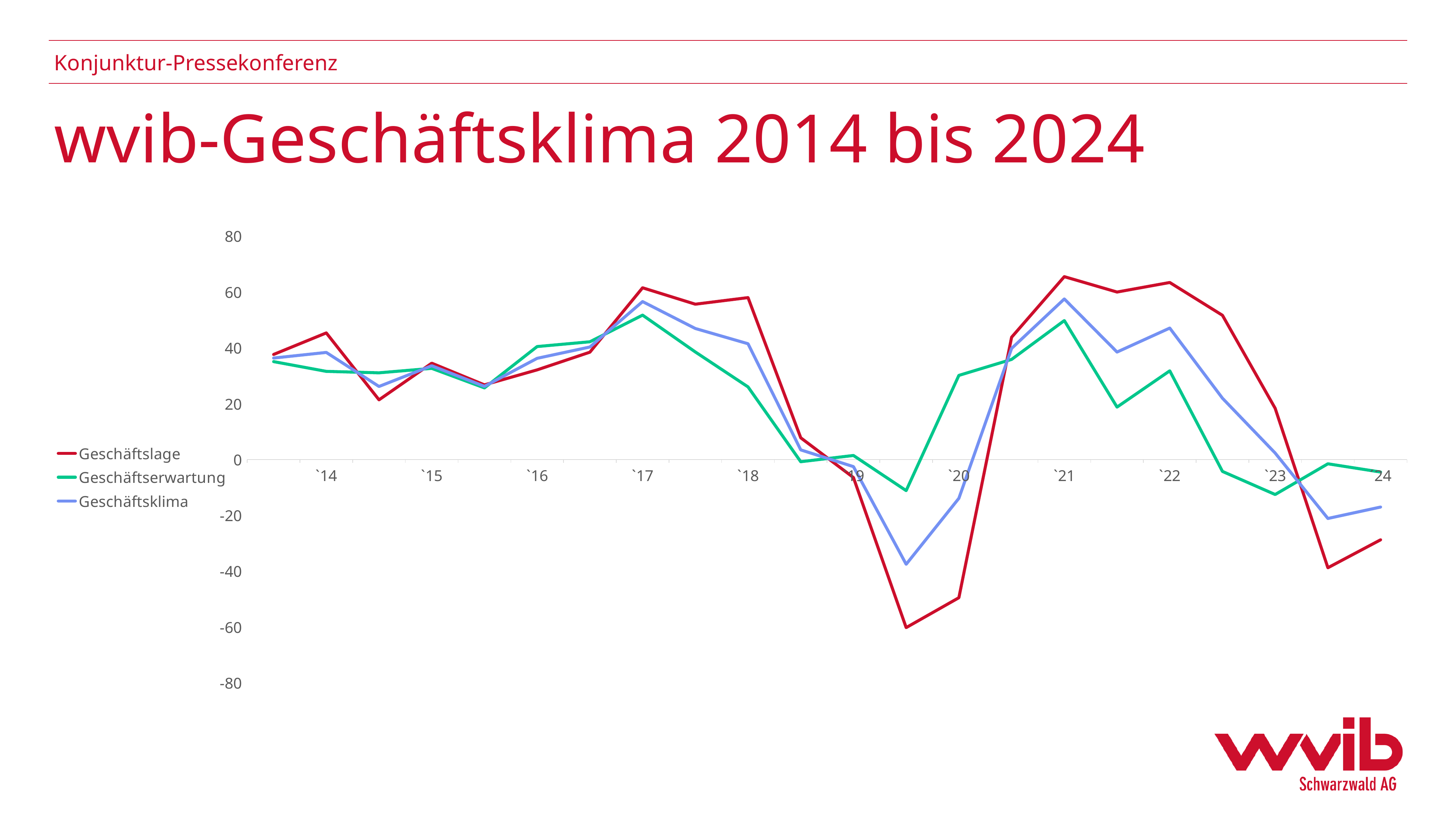
How many series does the legend list? 3 Is the value for Geschäftsklima at `17 greater or less than 40? greater Does the Geschäftslage line rise or fall from `22 to `24? fall Is the value for Geschäftslage at `21 greater or less than 60? greater Is the value for Geschäftslage at `20 greater or less than -40? less What colour is the Geschäftslage line? red At `22, which is larger: Geschäftslage or Geschäftserwartung? Geschäftslage What kind of chart is shown on the slide? line chart Which series has the lowest value at `20? Geschäftslage Which series are listed in the legend? Geschäftslage, Geschäftserwartung, Geschäftsklima At `24, which is larger: Geschäftsklima or Geschäftslage? Geschäftsklima